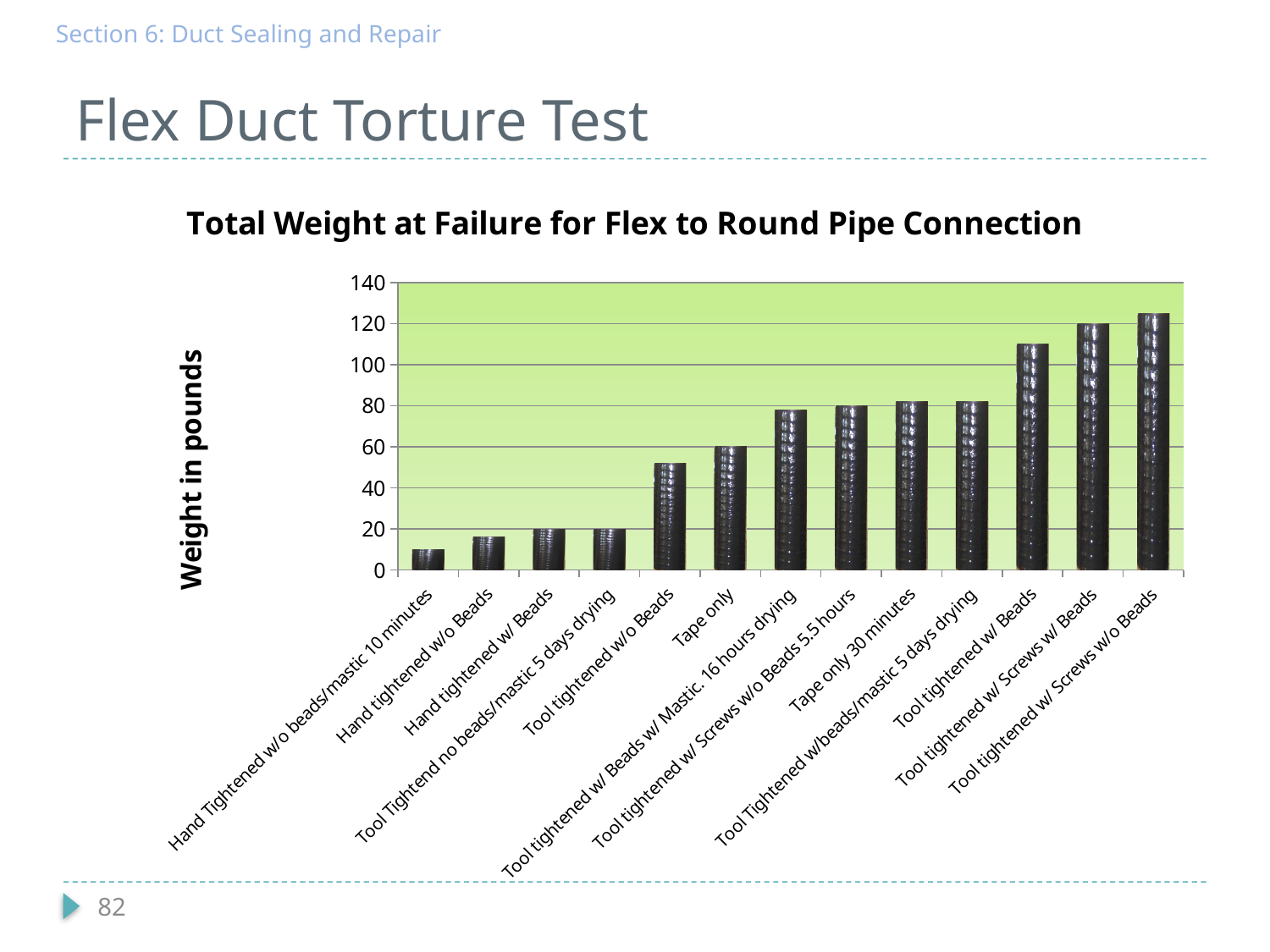
Do the bar values generally rise or fall from left to right along the x axis? rise What is the title of the chart? Total Weight at Failure for Flex to Round Pipe Connection Is the value for Tool tightened w/ Beads greater or less than 100? greater What is the label of the vertical axis? Weight in pounds Which is larger, the value for Tape only or the value for Tool tightened w/ Beads? Tool tightened w/ Beads Which category has the lowest weight at failure? Hand Tightened w/o beads/mastic 10 minutes Is the value for Tool tightened w/o Beads greater or less than 60? less Is the value for Hand tightened w/o Beads greater or less than 20? less Which category has the highest weight at failure? Tool tightened w/ Screws w/o Beads How many categories (bars) are plotted in the chart? 13 Which is larger, the value for Hand tightened w/ Beads or the value for Tool tightened w/o Beads? Tool tightened w/o Beads What kind of chart is shown on the slide? bar chart